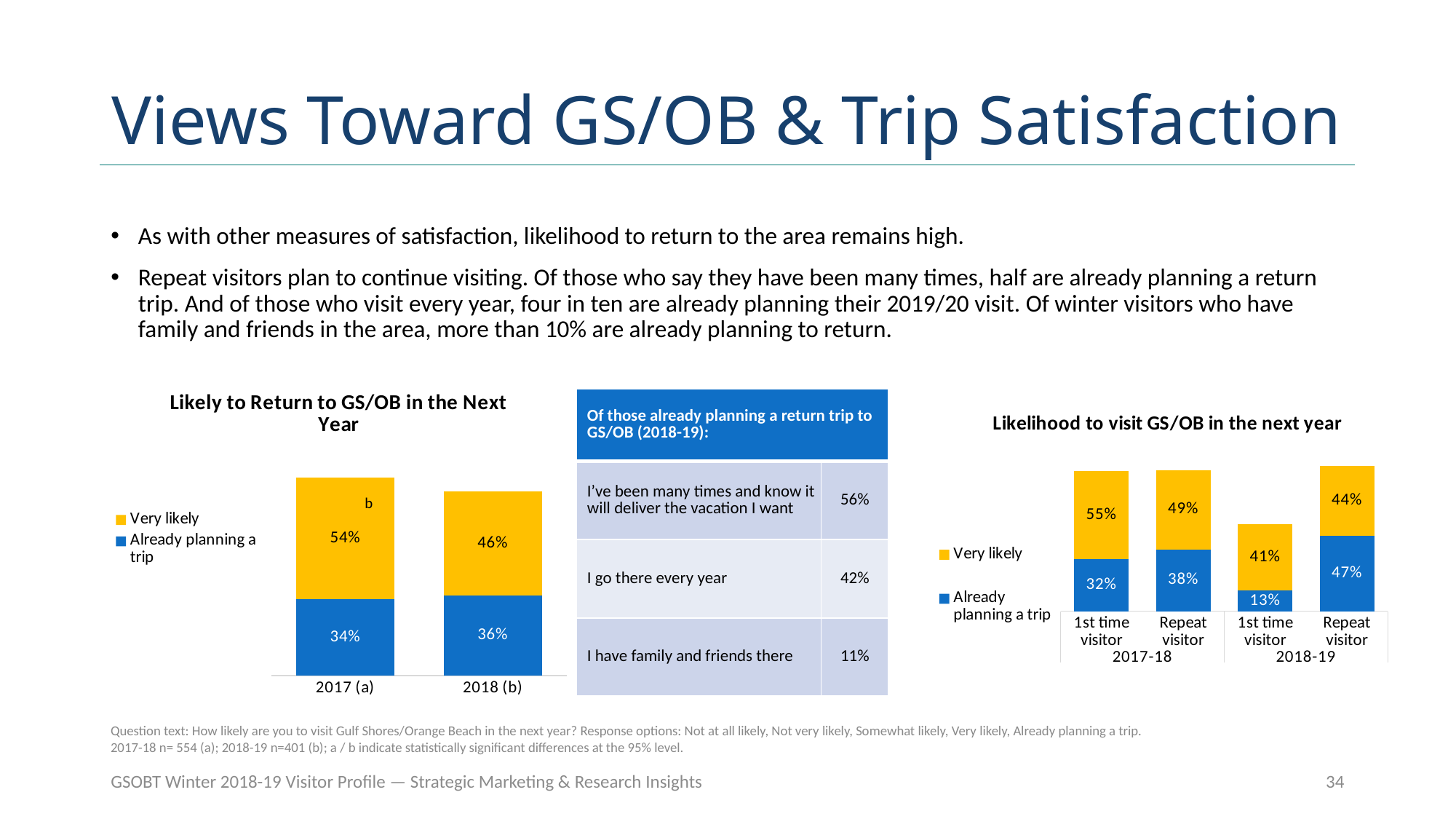
In the 'Likely to Return to GS/OB in the Next Year' chart, what is the 'Very likely' value for 2017 (a)? 54% In the 'Likelihood to visit GS/OB in the next year' chart, what is the 'Very likely' value for repeat visitors in 2017-18? 49% In the 'Likelihood to visit GS/OB in the next year' chart, what is the combined total of the 2018-19 repeat visitor bar? 91% In the 'Likelihood to visit GS/OB in the next year' chart, how many bars are plotted? 4 What kind of chart is 'Likelihood to visit GS/OB in the next year'? Stacked bar chart In the 'Likelihood to visit GS/OB in the next year' chart, which group has the lowest 'Very likely' value? 1st time visitor 2018-19 In the 'Likely to Return to GS/OB in the Next Year' chart, what is the 'Already planning a trip' value for 2018 (b)? 36% In the 'Likely to Return to GS/OB in the Next Year' chart, what is the combined total of the 2017 (a) bar? 88% In the 'Likelihood to visit GS/OB in the next year' chart, which group has the highest 'Already planning a trip' value? Repeat visitor 2018-19 In the 'Likely to Return to GS/OB in the Next Year' chart, how many series does the legend list? 2 In the 'Likely to Return to GS/OB in the Next Year' chart, by how much did the 'Very likely' share fall from 2017 (a) to 2018 (b)? 8 percentage points In the 'Likelihood to visit GS/OB in the next year' chart, what is the 'Already planning a trip' value for 1st time visitors in 2018-19? 13%